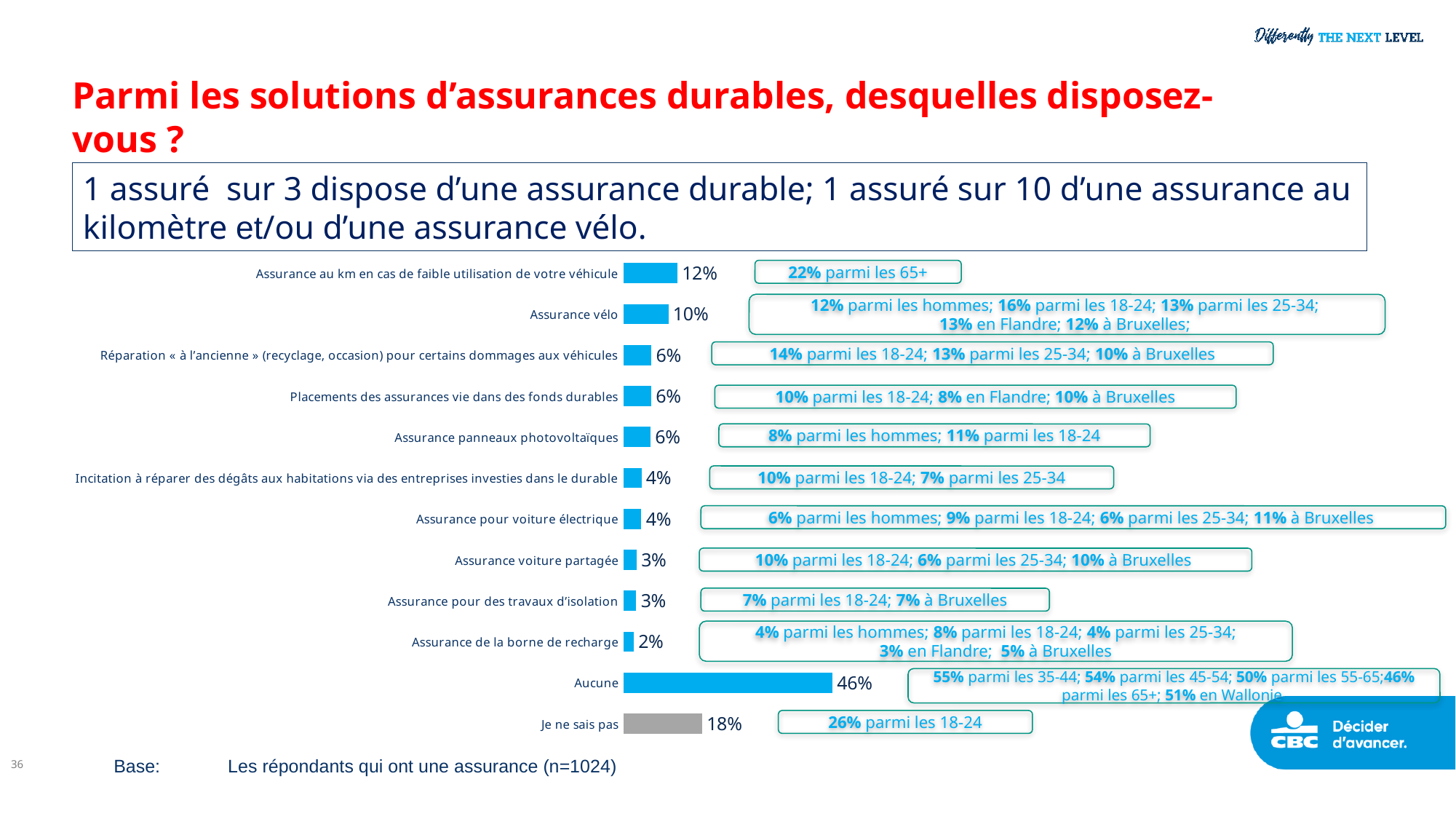
Which is larger, the value for "Assurance vélo" or the value for "Assurance pour voiture électrique"? Assurance vélo How many categories does the chart show? 12 What is the value for "Assurance vélo"? 10% Which category has the highest value? Aucune What is the value for "Je ne sais pas"? 18% Which category has the lowest value? Assurance de la borne de recharge What kind of chart is shown on the slide? Bar chart What is the difference between the values for "Assurance au km en cas de faible utilisation de votre véhicule" and "Assurance vélo"? 2% What is the value for "Assurance de la borne de recharge"? 2% What is the value for "Aucune"? 46% What is the value for "Assurance au km en cas de faible utilisation de votre véhicule"? 12% What is the difference between the values for "Aucune" and "Je ne sais pas"? 28%